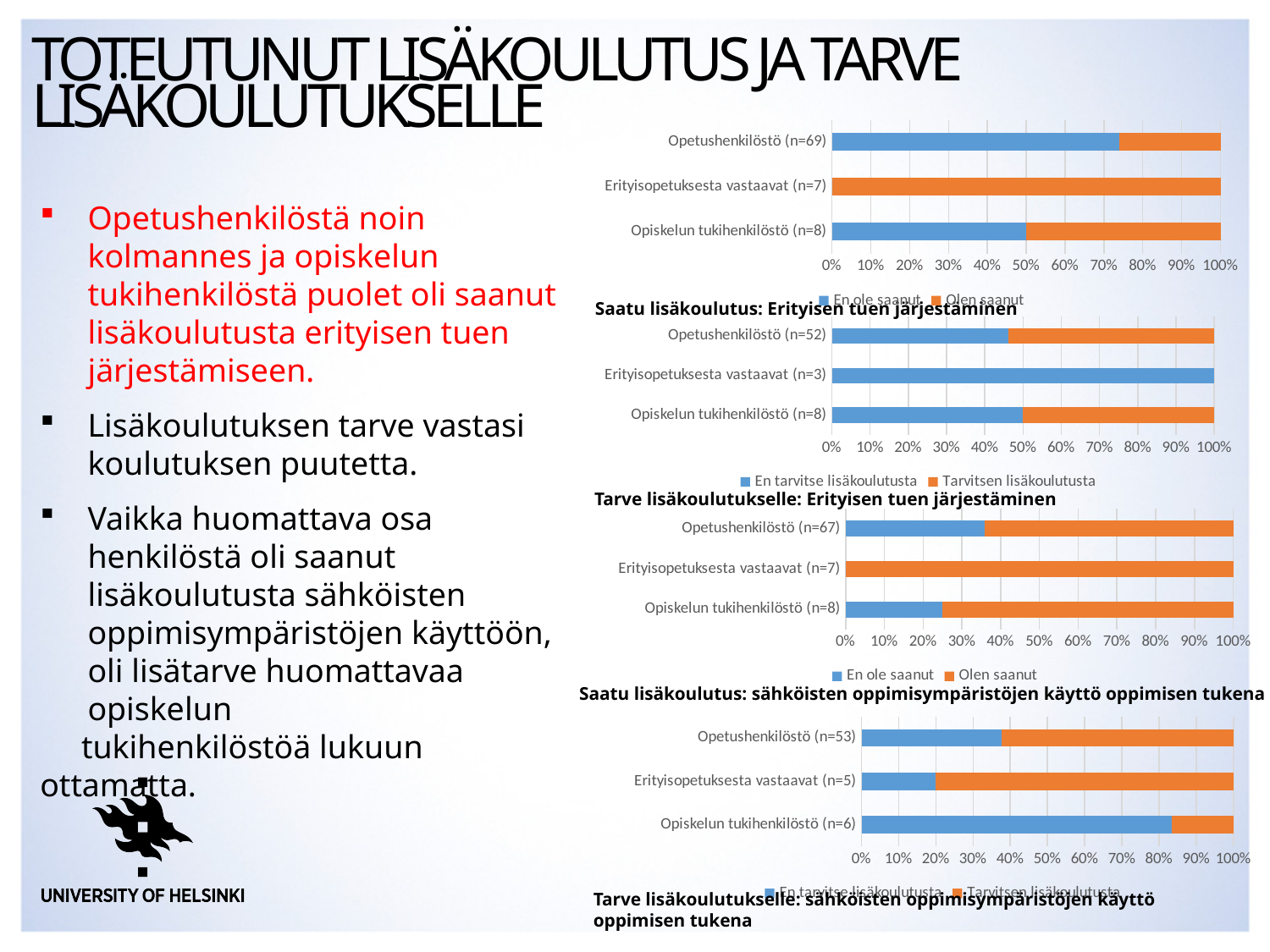
What are the two legend entries of the chart 'Saatu lisäkoulutus: sähköisten oppimisympäristöjen käyttö oppimisen tukena'? En ole saanut, Olen saanut In the chart 'Saatu lisäkoulutus: sähköisten oppimisympäristöjen käyttö oppimisen tukena', is the 'En ole saanut' share for Opetushenkilöstö (n=67) greater or less than 50%? less In the chart 'Tarve lisäkoulutukselle: Erityisen tuen järjestäminen', which category has the largest 'En tarvitse lisäkoulutusta' share? Erityisopetuksesta vastaavat (n=3) In the chart 'Tarve lisäkoulutukselle: sähköisten oppimisympäristöjen käyttö oppimisen tukena', is the 'En tarvitse lisäkoulutusta' share for Opiskelun tukihenkilöstö (n=6) greater or less than 70%? greater In the chart 'Tarve lisäkoulutukselle: sähköisten oppimisympäristöjen käyttö oppimisen tukena', which has the larger 'En tarvitse lisäkoulutusta' share: Opiskelun tukihenkilöstö (n=6) or Erityisopetuksesta vastaavat (n=5)? Opiskelun tukihenkilöstö (n=6) What kind of chart is the top chart, 'Saatu lisäkoulutus: Erityisen tuen järjestäminen'? Stacked bar chart In the chart 'Tarve lisäkoulutukselle: Erityisen tuen järjestäminen', is the 'En tarvitse lisäkoulutusta' share for Opetushenkilöstö (n=52) greater or less than 60%? less How many categories are shown in the chart 'Saatu lisäkoulutus: Erityisen tuen järjestäminen'? 3 How many series does the legend list for the chart 'Tarve lisäkoulutukselle: Erityisen tuen järjestäminen'? 2 In the chart 'Saatu lisäkoulutus: sähköisten oppimisympäristöjen käyttö oppimisen tukena', which category has the smallest 'En ole saanut' share? Erityisopetuksesta vastaavat (n=7)